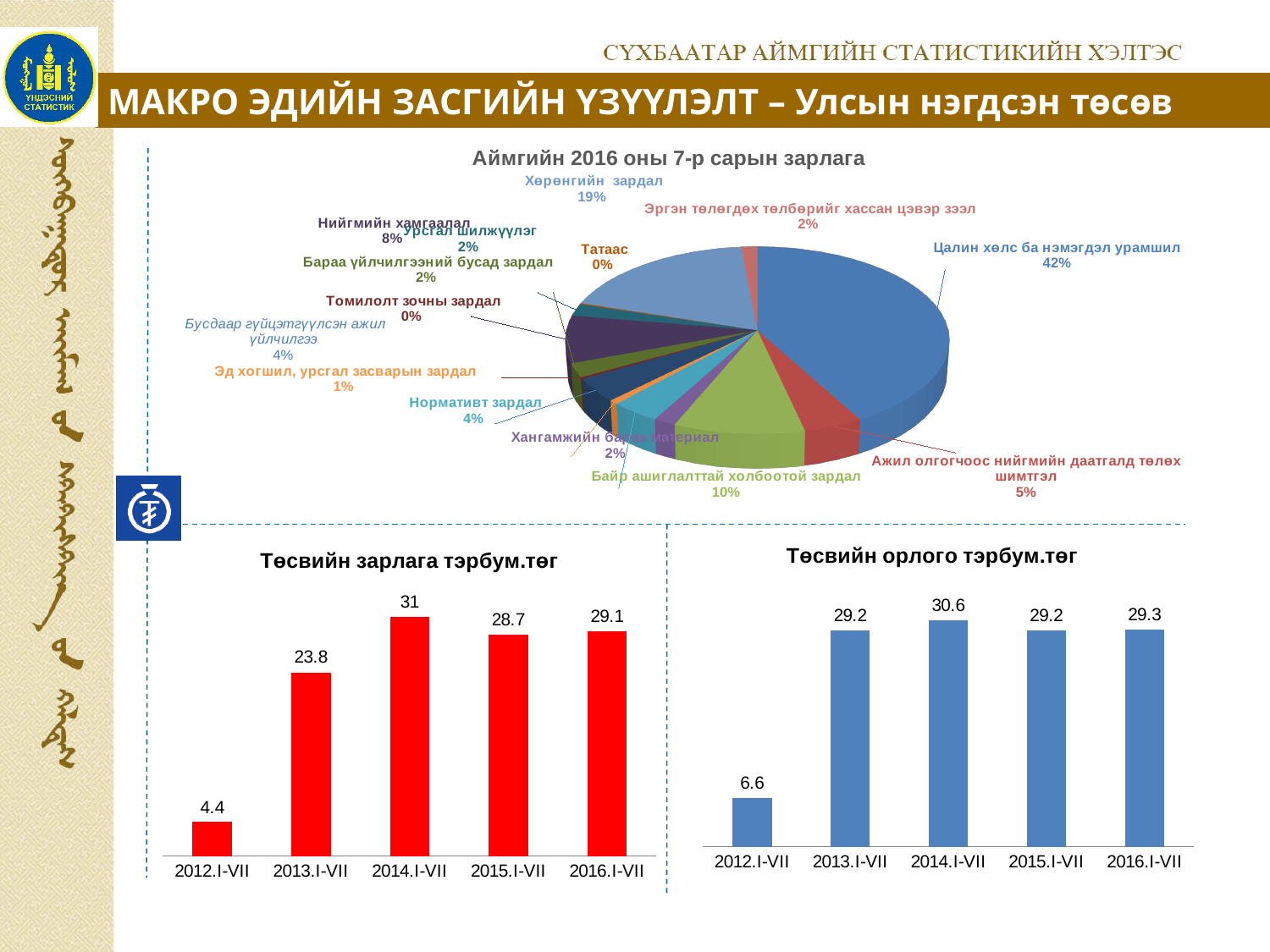
In the chart 'Төсвийн орлого тэрбум.төг', what is the value for 2016.I-VII? 29.3 In the pie chart 'Аймгийн 2016 оны 7-р сарын зарлага', what share is labelled for 'Байр ашиглалттай холбоотой зардал'? 10% In the chart 'Төсвийн зарлага тэрбум.төг', what is the difference between the values for 2014.I-VII and 2015.I-VII? 2.3 In the chart 'Төсвийн орлого тэрбум.төг', how many periods are shown on the x axis? 5 Which is larger: the 2013.I-VII value in 'Төсвийн зарлага тэрбум.төг' or the 2013.I-VII value in 'Төсвийн орлого тэрбум.төг'? Төсвийн орлого тэрбум.төг (29.2) What type of chart is 'Төсвийн зарлага тэрбум.төг'? Bar chart In the chart 'Төсвийн орлого тэрбум.төг', which period has the highest value? 2014.I-VII In the chart 'Төсвийн зарлага тэрбум.төг', which period has the lowest value? 2012.I-VII In the pie chart 'Аймгийн 2016 оны 7-р сарын зарлага', which category has the largest share? Цалин хөлс ба нэмэгдэл урамшил In the pie chart 'Аймгийн 2016 оны 7-р сарын зарлага', what share is labelled for 'Хөрөнгийн зардал'? 19% In the pie chart 'Аймгийн 2016 оны 7-р сарын зарлага', what share is labelled for 'Цалин хөлс ба нэмэгдэл урамшил'? 42% In the chart 'Төсвийн зарлага тэрбум.төг', what is the value for 2014.I-VII? 31